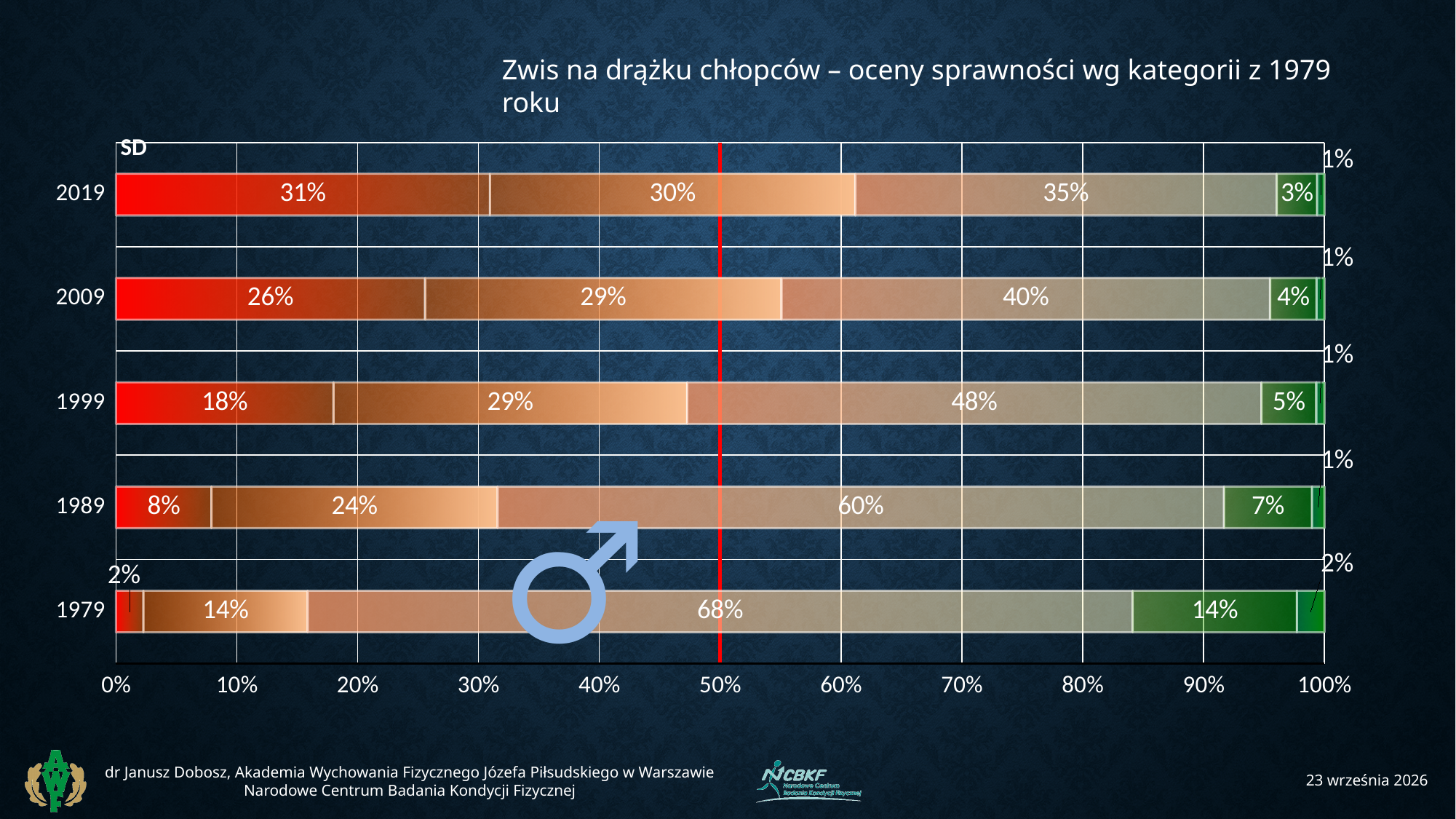
Which year has the lowest value for the middle (largest) segment? 2019 What is the value of the first (red) segment of the 2019 bar? 31% What is the difference between the middle segment values for 1979 (68%) and 2019 (35%)? 33% Which is larger: the green segment for 1979 or the green segment for 1999? 1979 What is the value of the second (orange) segment of the 2009 bar? 29% Does the first (red) segment value rise or fall from 1979 to 2019? rise What type of chart is shown on the slide? stacked bar chart What is the value of the green segment of the 1989 bar? 7% What is the value of the largest (middle) segment of the 1979 bar? 68% What is the title of the chart? Zwis na drążku chłopców – oceny sprawności wg kategorii z 1979 roku How many years (bars) are shown on the chart? 5 Which year has the highest value for the first (red) segment? 2019